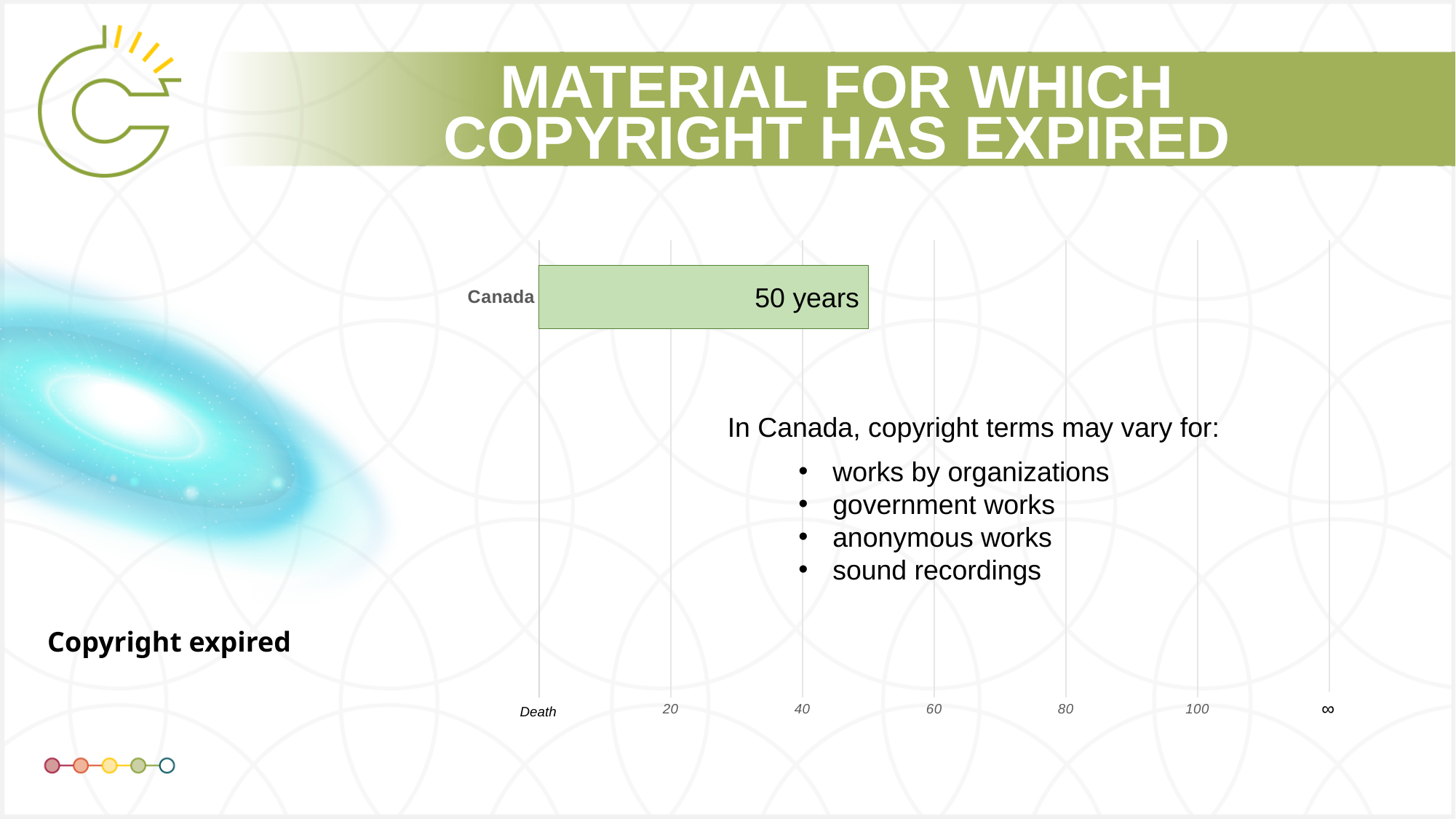
What is the label at the left end of the x axis? Death What kind of chart is shown on the slide? bar chart Which category is plotted in the chart? Canada How many categories are plotted in the chart? 1 What is the value shown for Canada? 50 years Is the value for Canada greater or less than 100? less What is the label at the right end of the x axis? ∞ Is the value for Canada greater or less than 60? less Is the value for Canada greater or less than 40? greater